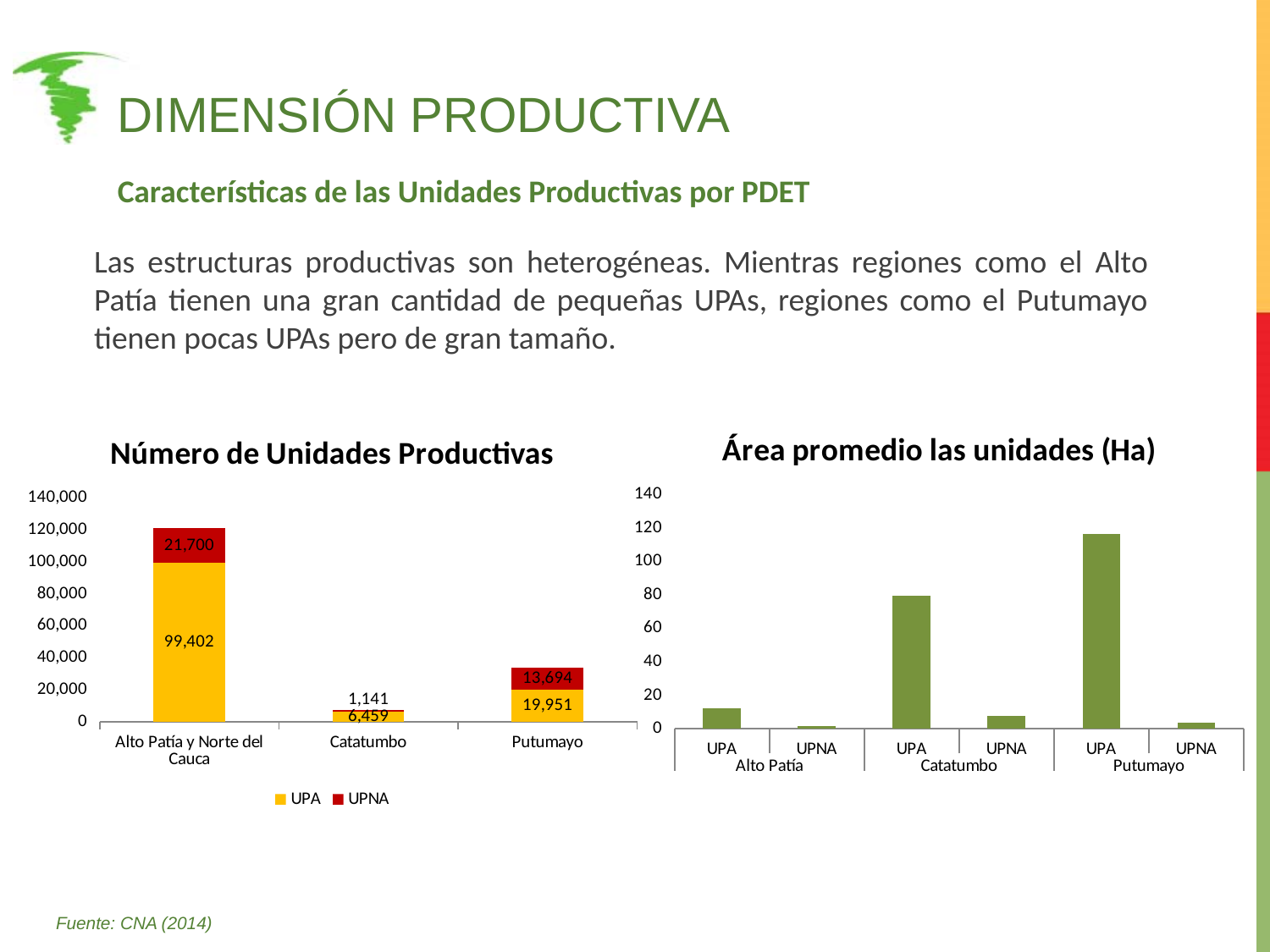
In the 'Número de Unidades Productivas' chart, what is the difference between the UPA and UPNA values for Putumayo? 6,257 In the 'Área promedio las unidades (Ha)' chart, is the value for UPA in Catatumbo greater or less than 60? greater In the 'Número de Unidades Productivas' chart, which region has the highest UPA value? Alto Patía y Norte del Cauca In the 'Número de Unidades Productivas' chart, what is the UPA value for Alto Patía y Norte del Cauca? 99,402 In the 'Número de Unidades Productivas' chart, how many series does the legend list? 2 What kind of chart is the 'Área promedio las unidades (Ha)' chart? Bar chart In the 'Número de Unidades Productivas' chart, what is the UPNA value for Putumayo? 13,694 In the 'Área promedio las unidades (Ha)' chart, which bar is the highest? UPA in Putumayo In the 'Número de Unidades Productivas' chart, what is the total of the stacked bar for Catatumbo? 7,600 In the 'Área promedio las unidades (Ha)' chart, is the value for UPA in Putumayo greater or less than 100? greater In the 'Número de Unidades Productivas' chart, which region has the lowest UPNA value? Catatumbo In the 'Número de Unidades Productivas' chart, what is the UPNA value for Catatumbo? 1,141